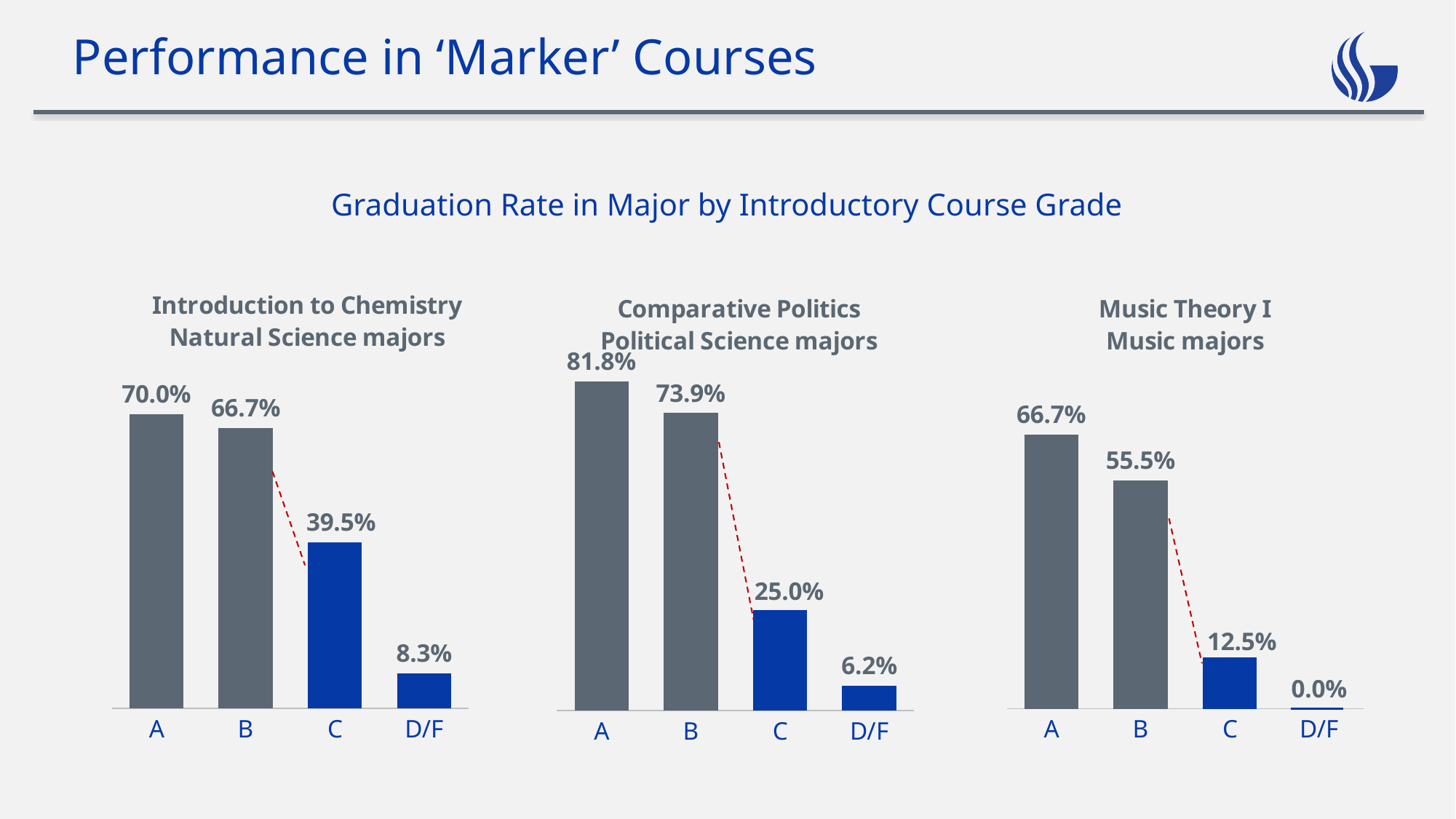
In the Music Theory I chart, what is the difference between the values for B and C? 43.0% How many charts are shown on the slide? 3 In the Comparative Politics chart, which grade has the highest graduation rate? A In the Introduction to Chemistry chart, what is the graduation rate for students who earned an A? 70.0% In the Music Theory I chart, what is the value for D/F? 0.0% In the Comparative Politics chart, what is the value for grade C? 25.0% In the Comparative Politics chart, what is the difference between the values for A and B? 7.9% What type of chart is used for Comparative Politics? Bar chart In the Introduction to Chemistry chart, which is larger, the value for B or the value for C? B In the Music Theory I chart, do the values rise or fall from A to D/F? Fall In the Introduction to Chemistry chart, which grade has the lowest graduation rate? D/F How many grade categories are shown in the Music Theory I chart? 4